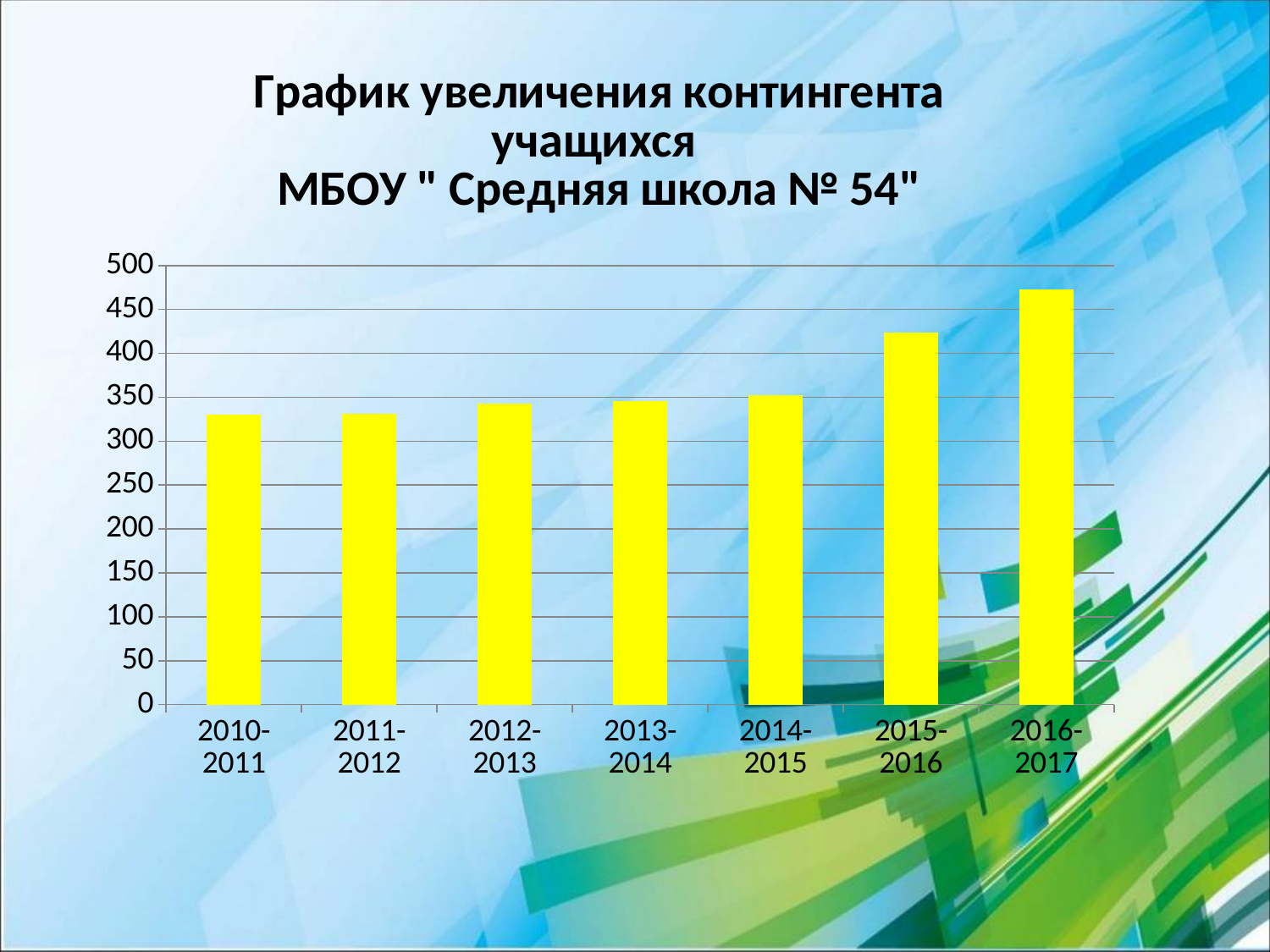
How many school years (categories) are shown on the x axis? 7 What kind of chart is shown on the slide? bar chart Is the value for 2015-2016 greater or less than 400? greater Do the values generally rise or fall from 2010-2011 to 2016-2017? rise Which is larger, the value for 2014-2015 or the value for 2015-2016? 2015-2016 Is the value for 2010-2011 greater or less than 300? greater Is the value for 2016-2017 greater or less than 450? greater Which school year has the highest number of students? 2016-2017 Which is larger, the value for 2016-2017 or the value for 2015-2016? 2016-2017 What colour are the bars in the chart? yellow